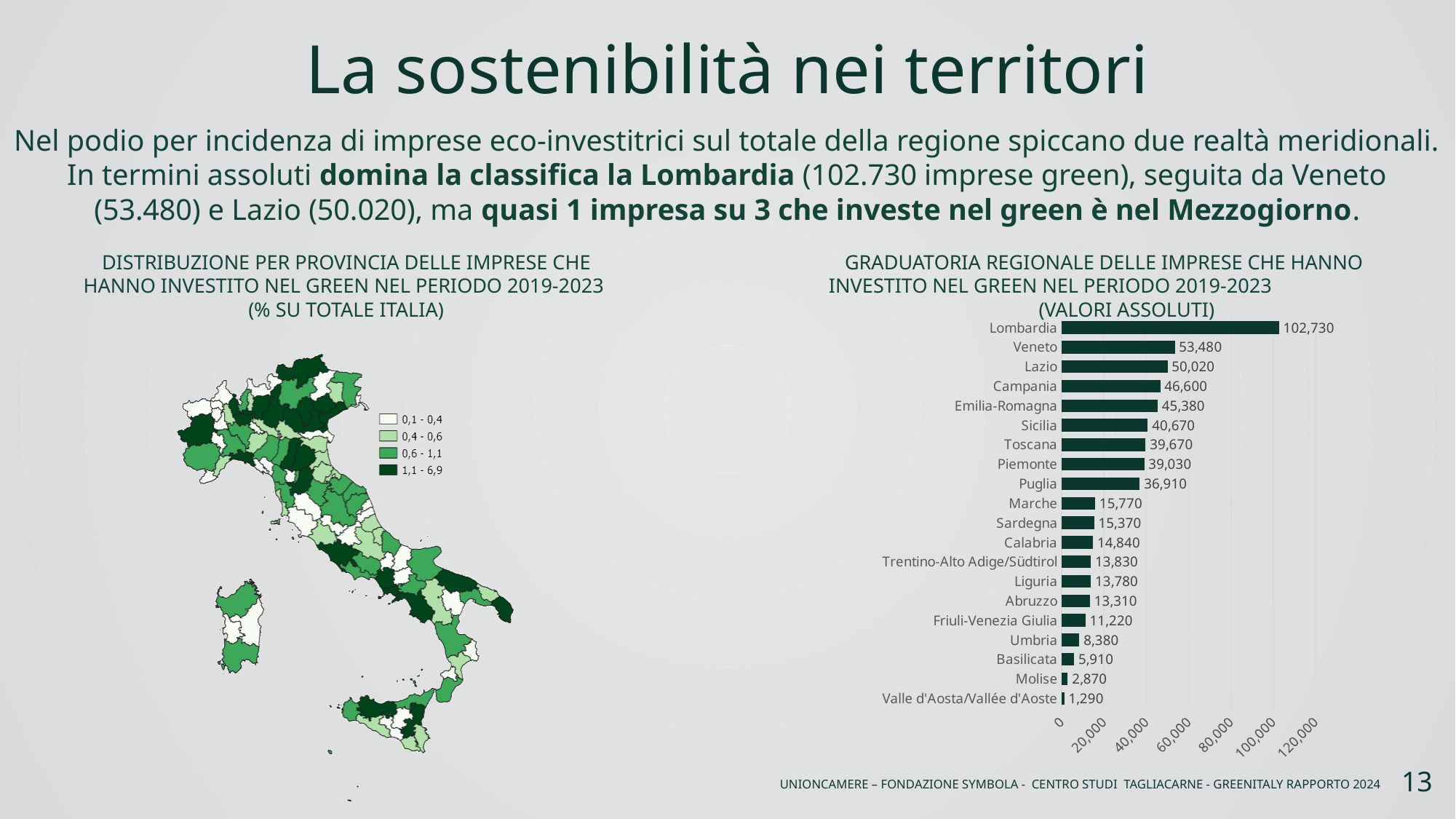
In the bar chart on the right, what is the difference between the values for Puglia and Marche? 21,140 In the bar chart on the right, which has a larger value, Toscana or Calabria? Toscana How many classes does the legend of the map on the left list? 4 In the bar chart on the right, which region has the highest value? Lombardia In the bar chart on the right, what is the value for Sicilia? 40,670 In the bar chart on the right, which region has the lowest value? Valle d'Aosta/Vallée d'Aoste How many regions are listed in the bar chart on the right? 20 What kind of chart is shown on the right side of the slide? Bar chart In the bar chart on the right, how many green-investing enterprises does Lombardia have? 102,730 In the bar chart on the right, what is the difference between the values for Lombardia and Veneto? 49,250 In the bar chart on the right, is the value for Campania greater or less than 40,000? greater In the bar chart on the right, what is the value for Valle d'Aosta/Vallée d'Aoste? 1,290